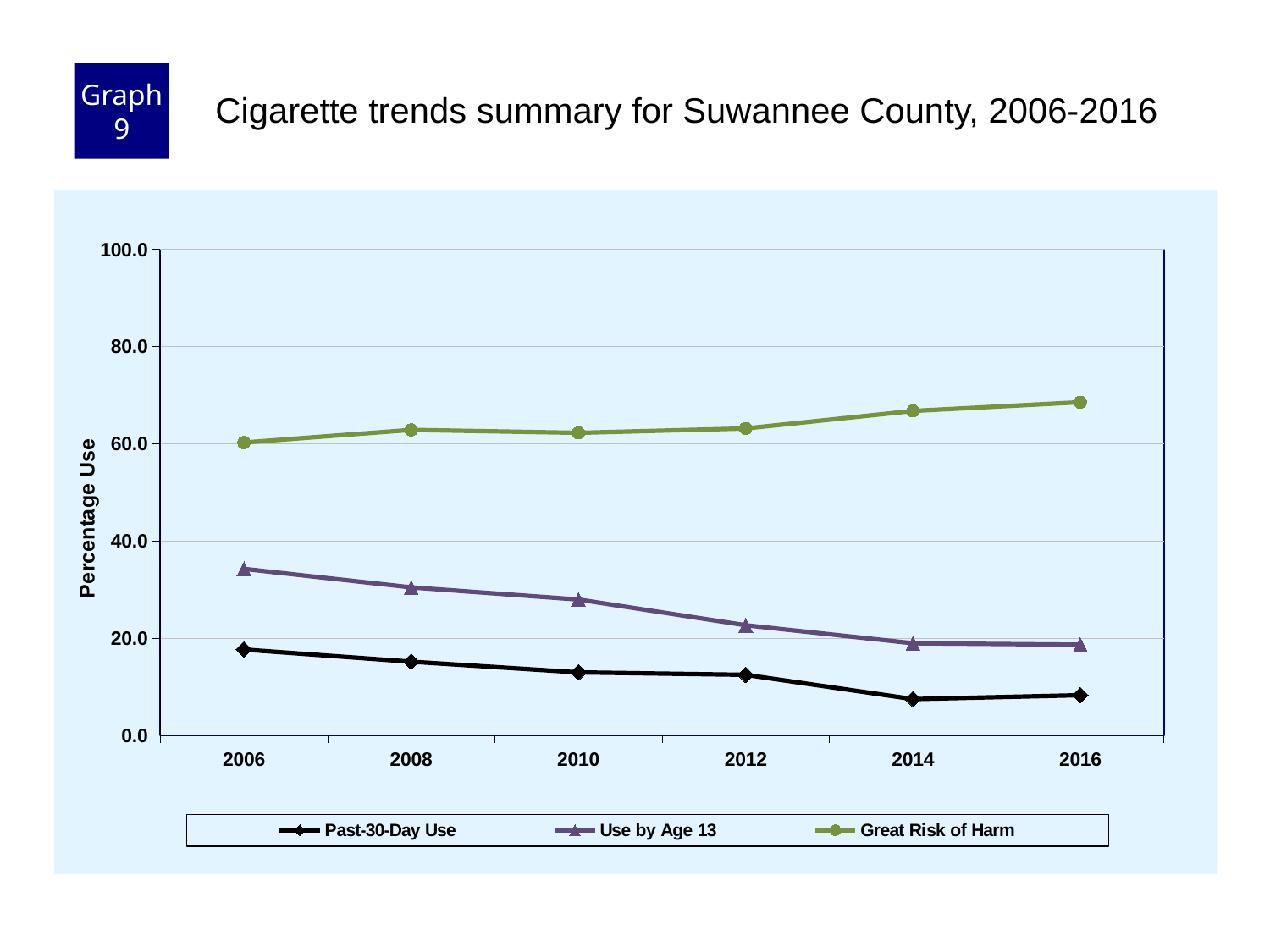
Is the value for Use by Age 13 in 2006 greater or less than 40.0? less Does the Great Risk of Harm series rise or fall from 2006 to 2016? rise What kind of chart is shown on the slide? line chart In 2012, which is larger: Use by Age 13 or Past-30-Day Use? Use by Age 13 How many years are plotted along the x axis? 6 Does the Use by Age 13 series rise or fall from 2006 to 2016? fall Is the value for Great Risk of Harm in 2016 greater or less than 60.0? greater Which series has the lowest values across all years? Past-30-Day Use What is the label on the y axis? Percentage Use Which series has the highest values across all years? Great Risk of Harm Is the value for Past-30-Day Use in 2014 greater or less than 20.0? less How many series does the legend list? 3